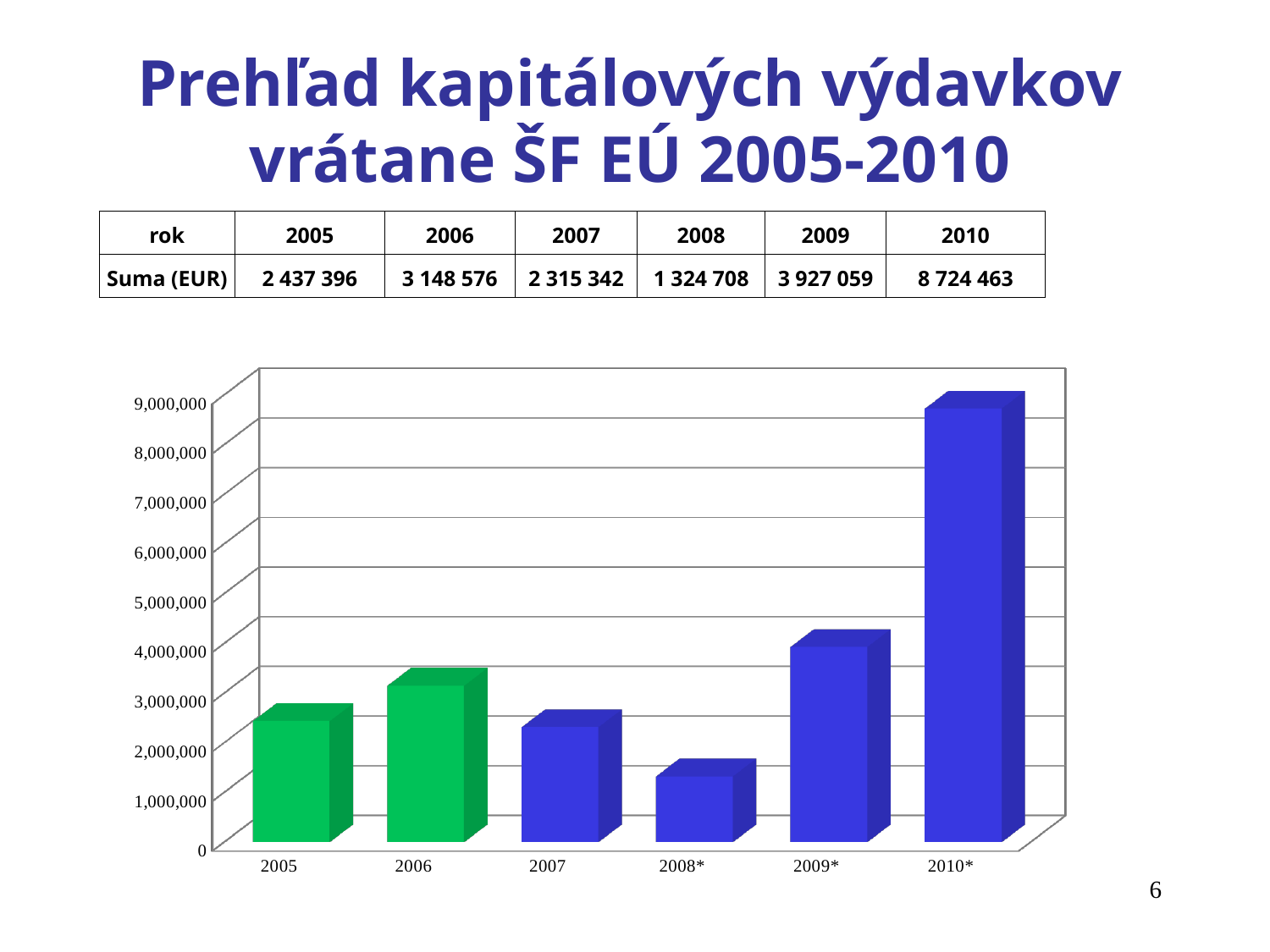
Which year has the lowest value in the chart? 2008 What is the difference between the values for 2006 and 2005? 711 180 Which year has the highest value in the chart? 2010 What kind of chart is shown on the slide? bar chart Which years are shown with green bars in the chart? 2005 and 2006 Is the value for 2009 greater or less than 3,000,000? greater What is the value for 2006 in the chart? 3 148 576 What is the value for 2010 in the chart? 8 724 463 How many years are shown in the chart? 6 Which is larger, the value for 2007 or the value for 2009? 2009 What is the difference between the values for 2010 and 2009? 4 797 404 What is the value for 2008 in the chart? 1 324 708